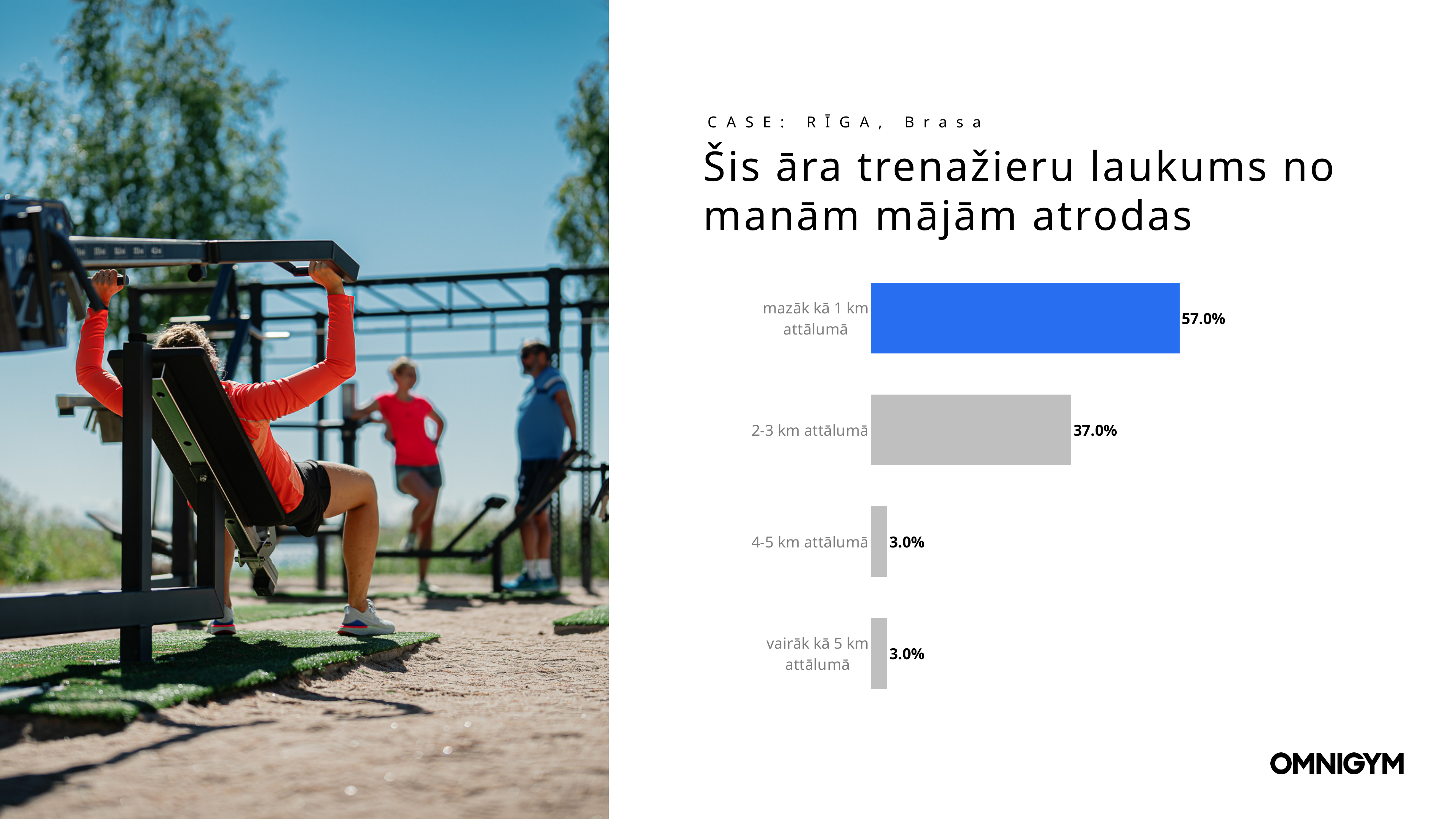
What kind of chart is shown on the slide? bar chart Which is larger, the value for "2-3 km attālumā" or the value for "4-5 km attālumā"? 2-3 km attālumā What is the value for "vairāk kā 5 km attālumā"? 3.0% What is the difference between the values for "2-3 km attālumā" and "vairāk kā 5 km attālumā"? 34.0% What is the difference between the values for "mazāk kā 1 km attālumā" and "2-3 km attālumā"? 20.0% Which category has the highest value? mazāk kā 1 km attālumā How many categories are shown in the chart? 4 What is the value for "mazāk kā 1 km attālumā"? 57.0% What is the value for "2-3 km attālumā"? 37.0% What is the title of the chart? Šis āra trenažieru laukums no manām mājām atrodas What is the value for "4-5 km attālumā"? 3.0% Which bar in the chart is coloured blue? mazāk kā 1 km attālumā